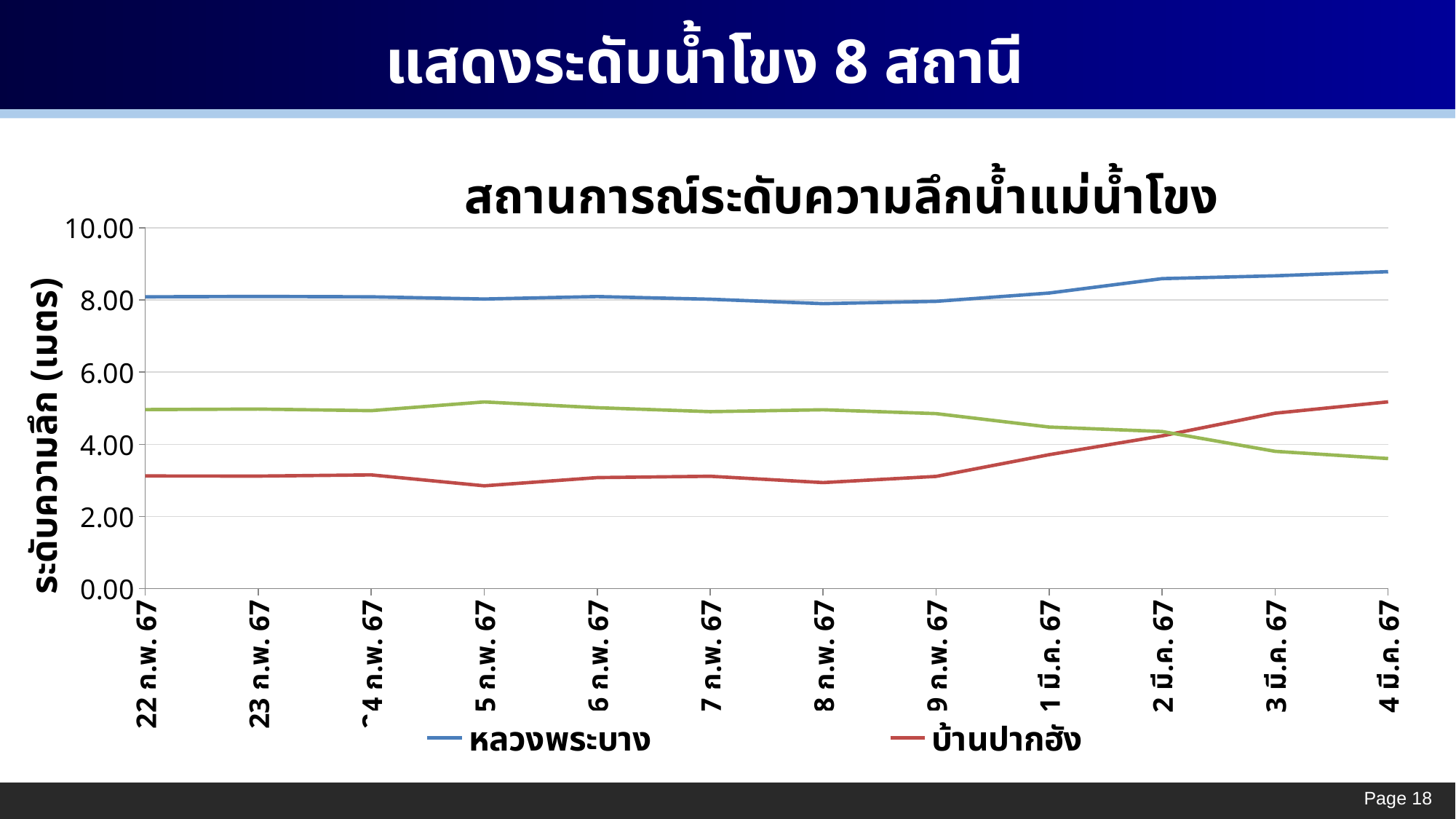
What is the title of the chart? สถานการณ์ระดับความลึกน้ำแม่น้ำโขง What is the label of the vertical axis of the chart? ระดับความลึก (เมตร) On which date does บ้านปากฮัง reach its highest value? 4 มี.ค. 67 Is the value for หลวงพระบาง on 22 ก.พ. 67 greater or less than 6.00? greater Is the value for บ้านปากฮัง on 22 ก.พ. 67 greater or less than 4.00? less On 22 ก.พ. 67, which series has the higher value, หลวงพระบาง or บ้านปากฮัง? หลวงพระบาง Does the value for บ้านปากฮัง rise or fall overall from 22 ก.พ. 67 to 4 มี.ค. 67? rise How many dates are shown along the x axis of the chart? 12 Is the value for หลวงพระบาง on 4 มี.ค. 67 greater or less than 8.00? greater What kind of chart is shown on the slide? line chart How many series does the chart legend list? 2